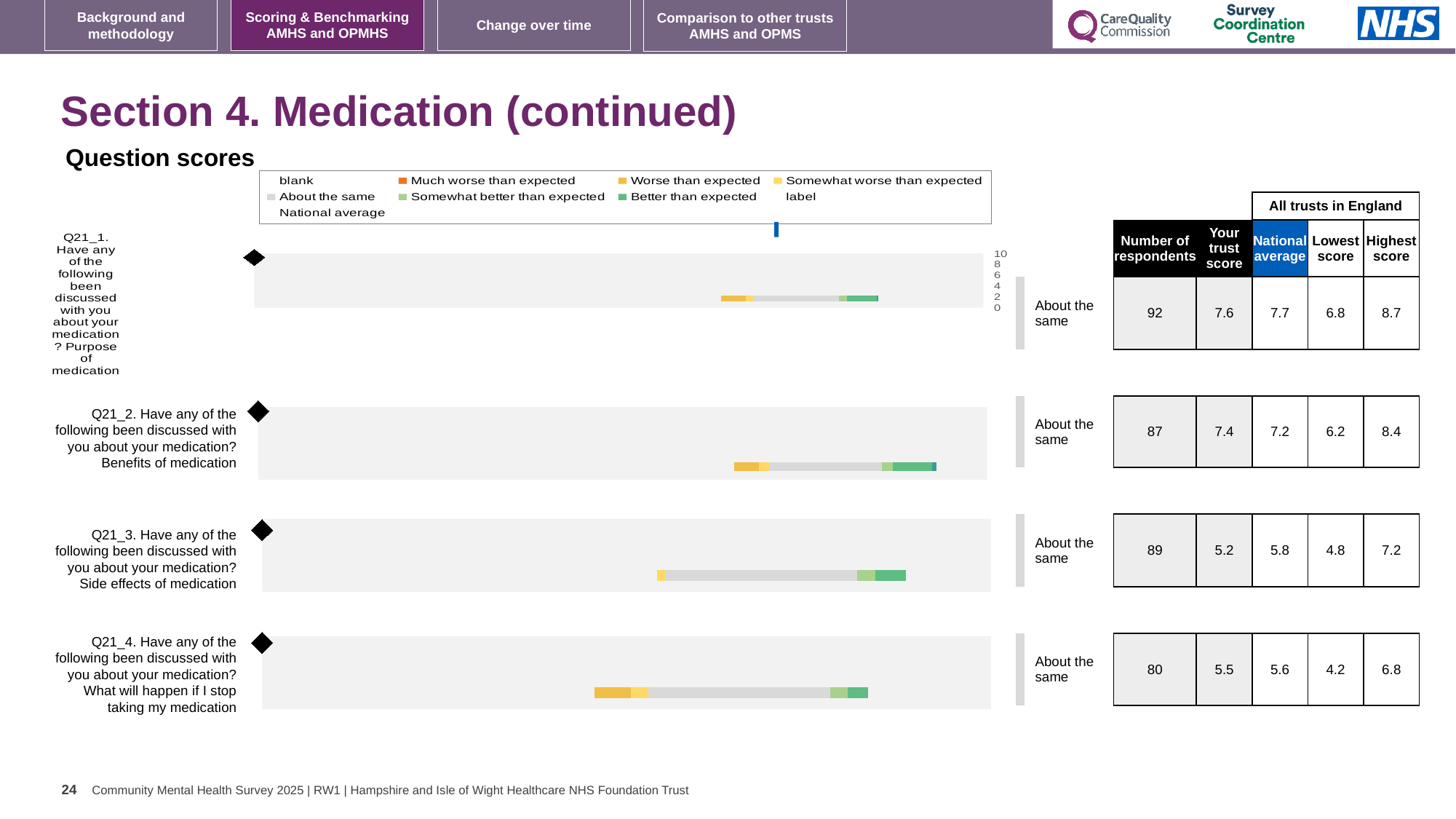
How many questions (Q21_1 to Q21_4) have a score chart on this slide? 4 For Q21_1, what is the difference between the highest score and the lowest score across all trusts in England? 1.9 What is the trust score for Q21_2 (Benefits of medication)? 7.4 For Q21_2, is the trust score higher or lower than the national average? higher What is the lowest score across all trusts in England for Q21_4? 4.2 Which question has the highest trust score? Q21_1 (Purpose of medication) How many respondents answered Q21_4 (What will happen if I stop taking my medication)? 80 What kind of chart is used to show the question scores on this slide? bar chart What benchmark category is shown for all four questions on this slide? About the same What is the national average for Q21_3 (Side effects of medication)? 5.8 In the legend, which colour represents 'Much worse than expected'? orange Which question has the lowest trust score? Q21_3 (Side effects of medication)